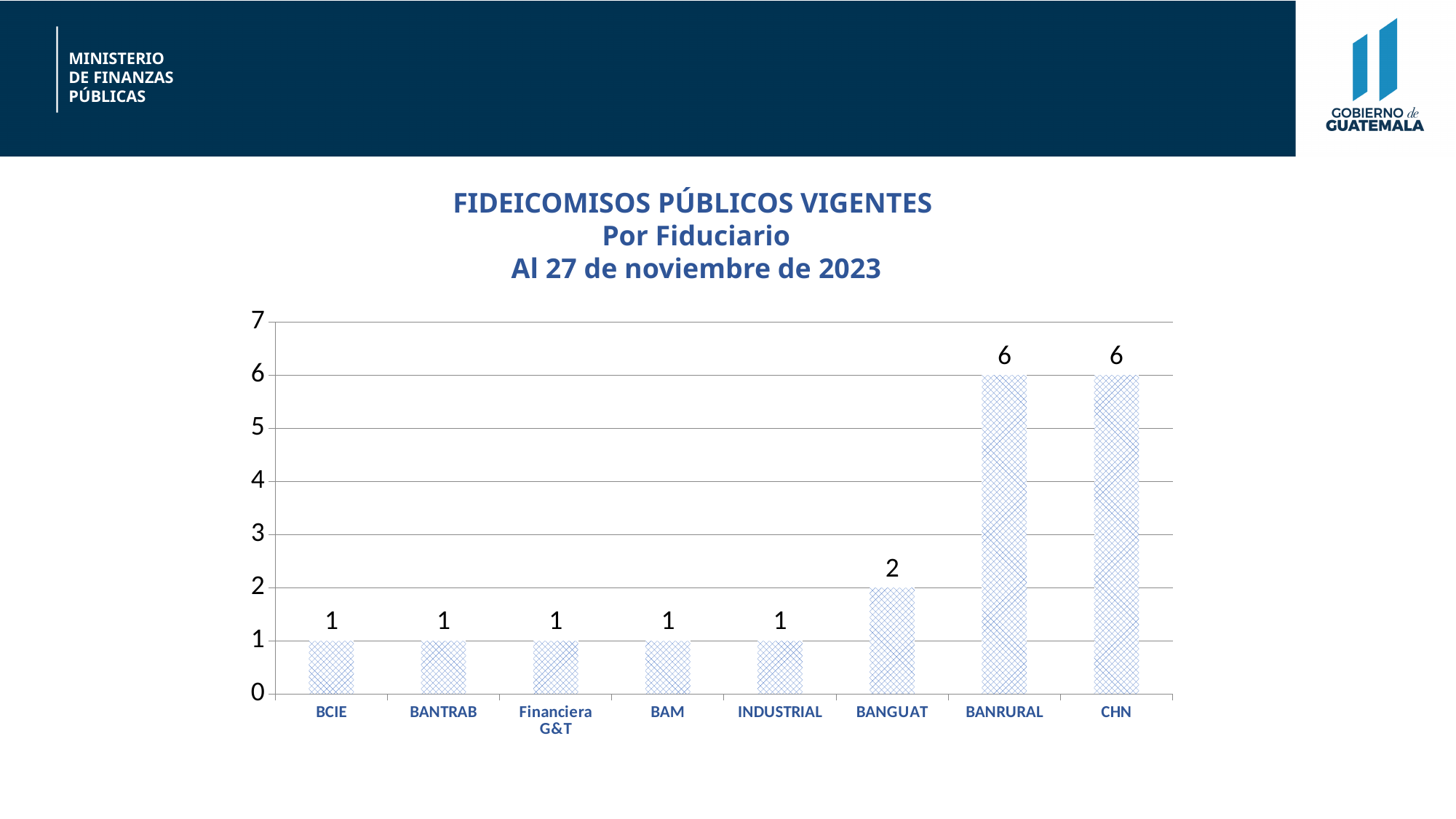
Is the value for BANRURAL greater or less than 4? greater Which categories have the highest value? BANRURAL and CHN What kind of chart is shown on the slide? bar chart What is the value for BANRURAL? 6 What is the value for Financiera G&T? 1 What date is given in the chart title? 27 de noviembre de 2023 Which is larger, the value for BANGUAT or the value for INDUSTRIAL? BANGUAT What is the value for BCIE? 1 How many categories are shown on the x axis? 8 What is the difference between the values for CHN and BANGUAT? 4 What is the value for BANGUAT? 2 What is the total of the values for BANRURAL and CHN? 12